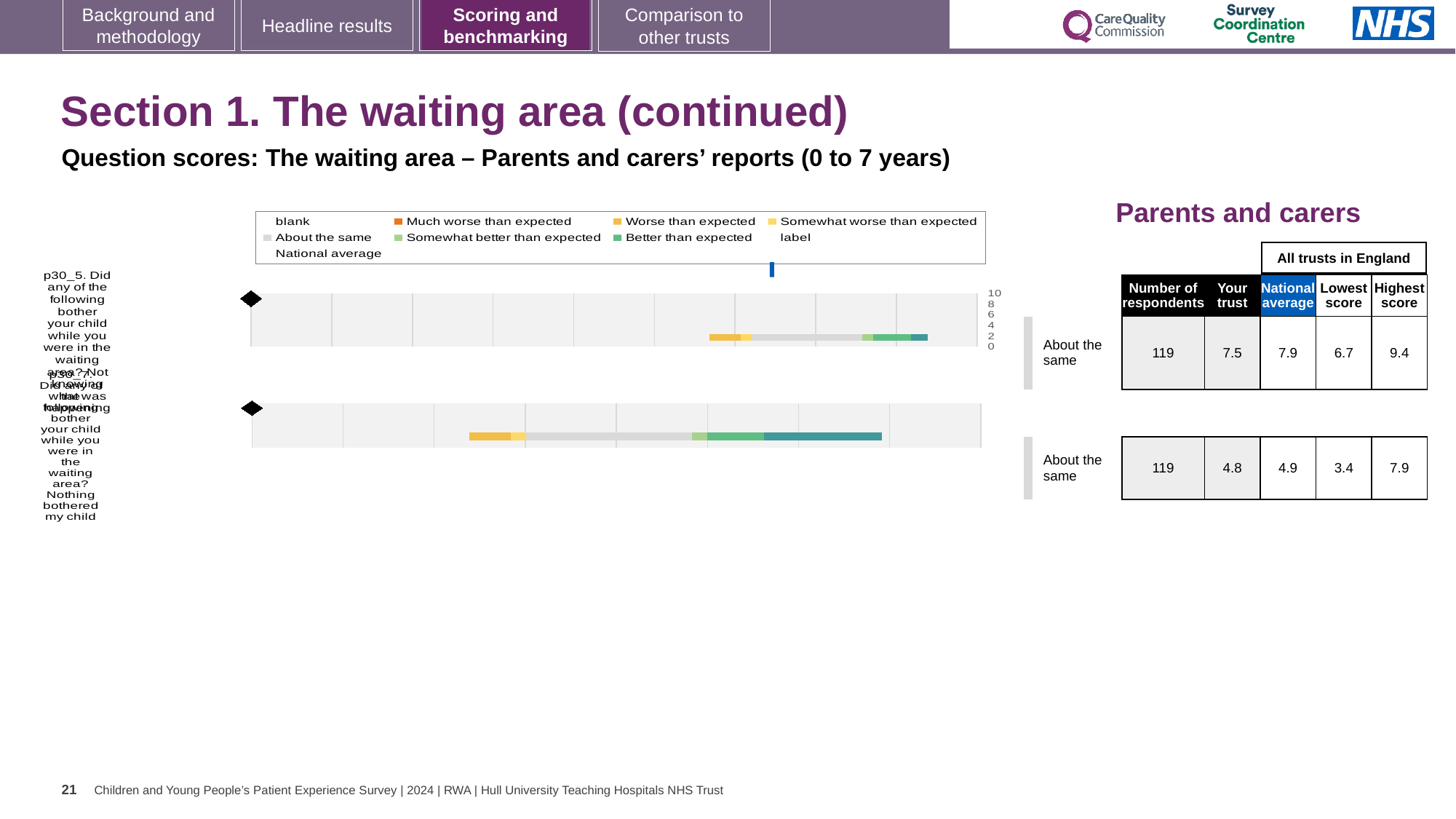
Which legend entry is shown in dark orange? Much worse than expected What is the difference between the national average and the 'Your trust' score for the first question (p30_5)? 0.4 What is the lowest score across all trusts in England for the second question (p30_7)? 3.4 How many question bars are plotted in the chart? 2 How many respondents answered the first question (p30_5)? 119 What benchmark category is shown next to both bars in the chart? About the same What kind of chart is shown on the left of the slide? bar chart What is the difference between the highest and lowest scores for the second question (p30_7)? 4.5 For the first question (p30_5), which is larger: the 'Your trust' score or the national average? national average According to the table, what is the 'Your trust' score for the first question (p30_5)? 7.5 What is the highest score across all trusts in England for the first question (p30_5)? 9.4 According to the table, what is the national average for the second question (p30_7)? 4.9